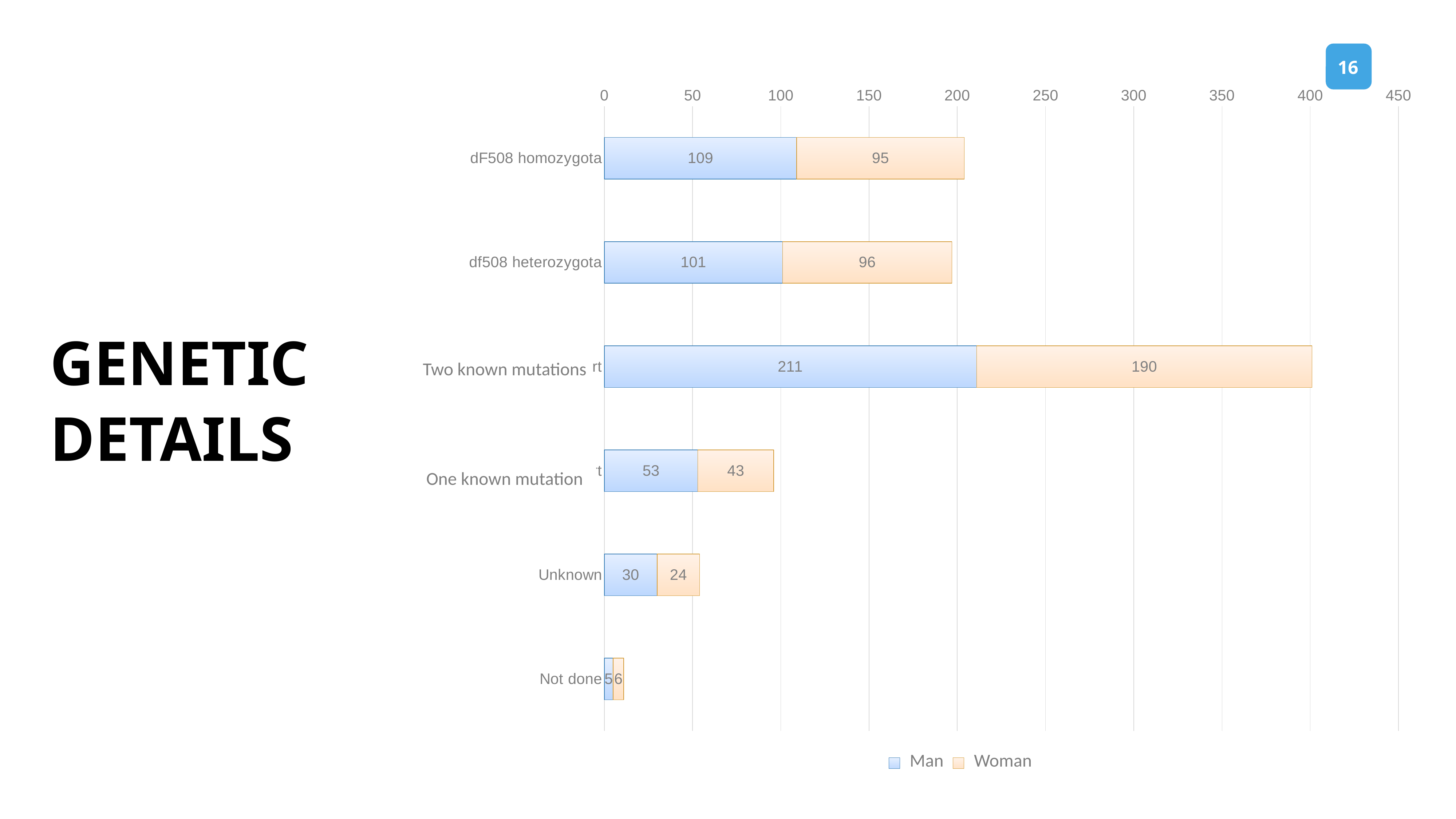
What is the Man value for dF508 homozygota? 109 Which is larger, the Man value for df508 heterozygota or the Man value for dF508 homozygota? dF508 homozygota What is the total of the stacked bar for Two known mutations? 401 What is the Woman value for Two known mutations? 190 What is the difference between the Man and Woman values for One known mutation? 10 How many series does the legend list? 2 What is the total of the stacked bar for Unknown? 54 What is the Woman value for Unknown? 24 How many categories are shown on the chart? 6 Which category has the lowest Woman value? Not done What kind of chart is shown on the slide? Stacked bar chart Which category has the highest Man value? Two known mutations